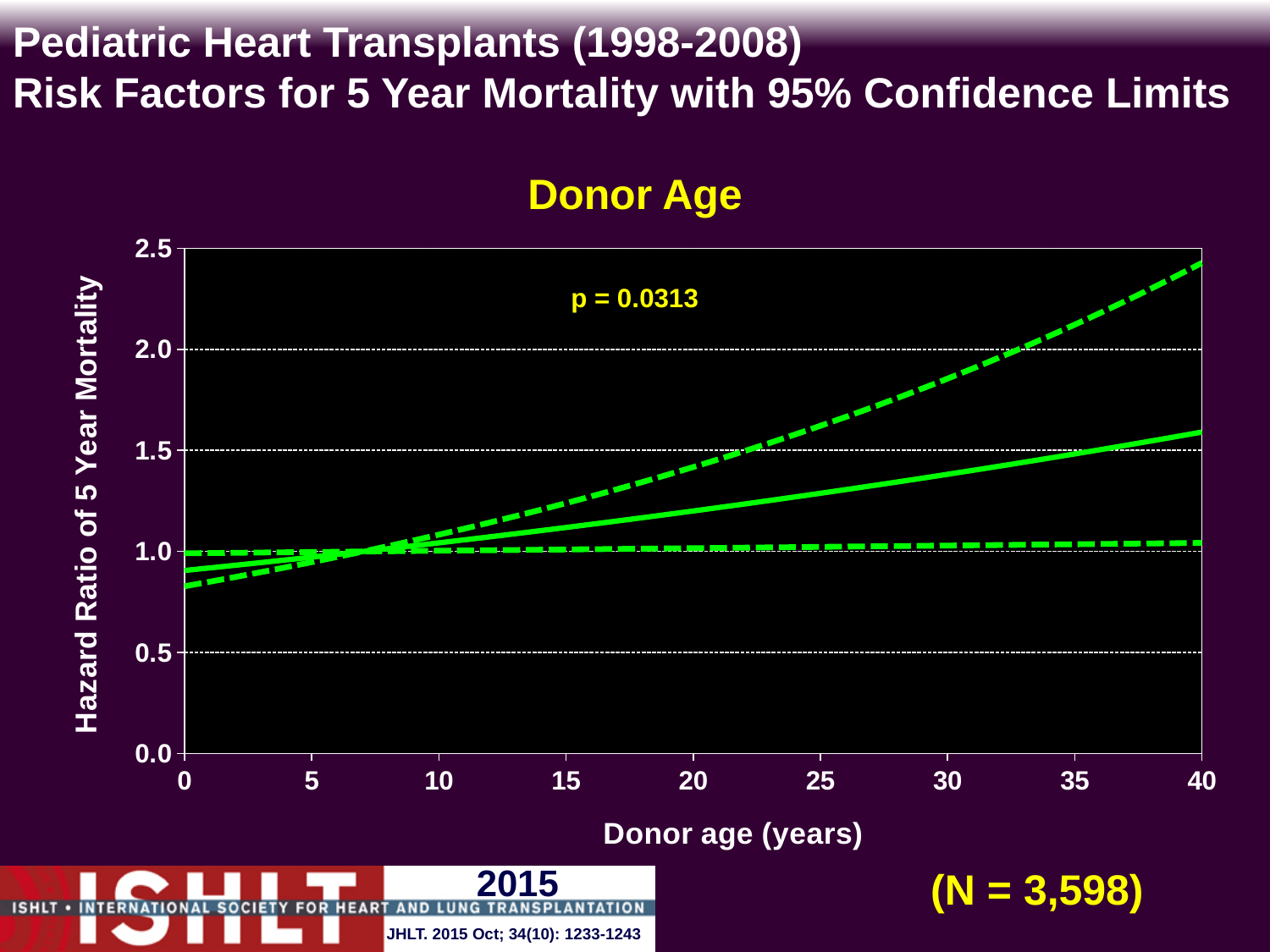
What kind of chart is shown on the slide? line chart What is the maximum value shown on the y axis of the chart? 2.5 What is the title of the chart? Donor Age Is the value of the solid hazard ratio line at a donor age of 20 years greater or less than 1.0? greater What p-value is printed on the chart? p = 0.0313 Is the value of the upper dashed confidence limit at a donor age of 40 years greater or less than 2.0? greater Is the value of the solid hazard ratio line at a donor age of 0 years greater or less than 1.0? less Does the solid hazard ratio line rise or fall as donor age increases? rises Does the upper dashed confidence limit rise or fall as donor age increases from 0 to 40 years? rises How many lines are plotted on the chart? 3